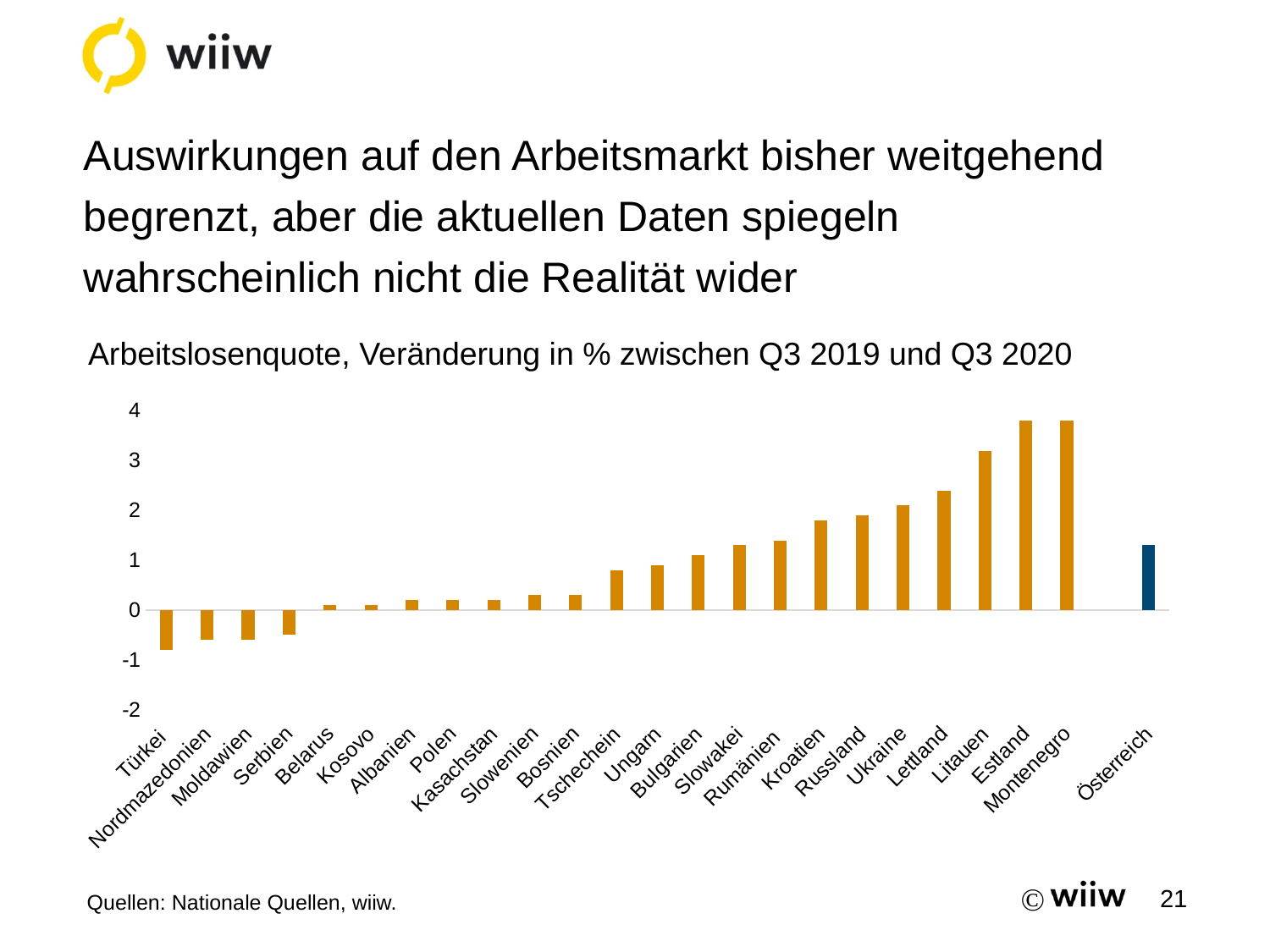
Is the value for Estland greater or less than 3? greater Which has the larger value, Ukraine or Österreich? Ukraine Is the value for Kroatien greater or less than 2? less What is the title of the chart? Arbeitslosenquote, Veränderung in % zwischen Q3 2019 und Q3 2020 Is the value for Österreich greater or less than 1? greater What kind of chart is shown on the slide? Bar chart Which country has the lowest value in the chart? Türkei Which has the larger value, Litauen or Lettland? Litauen How many countries are shown on the x axis of the chart? 24 Which country's bar is shown in a different colour (dark blue) from the others? Österreich